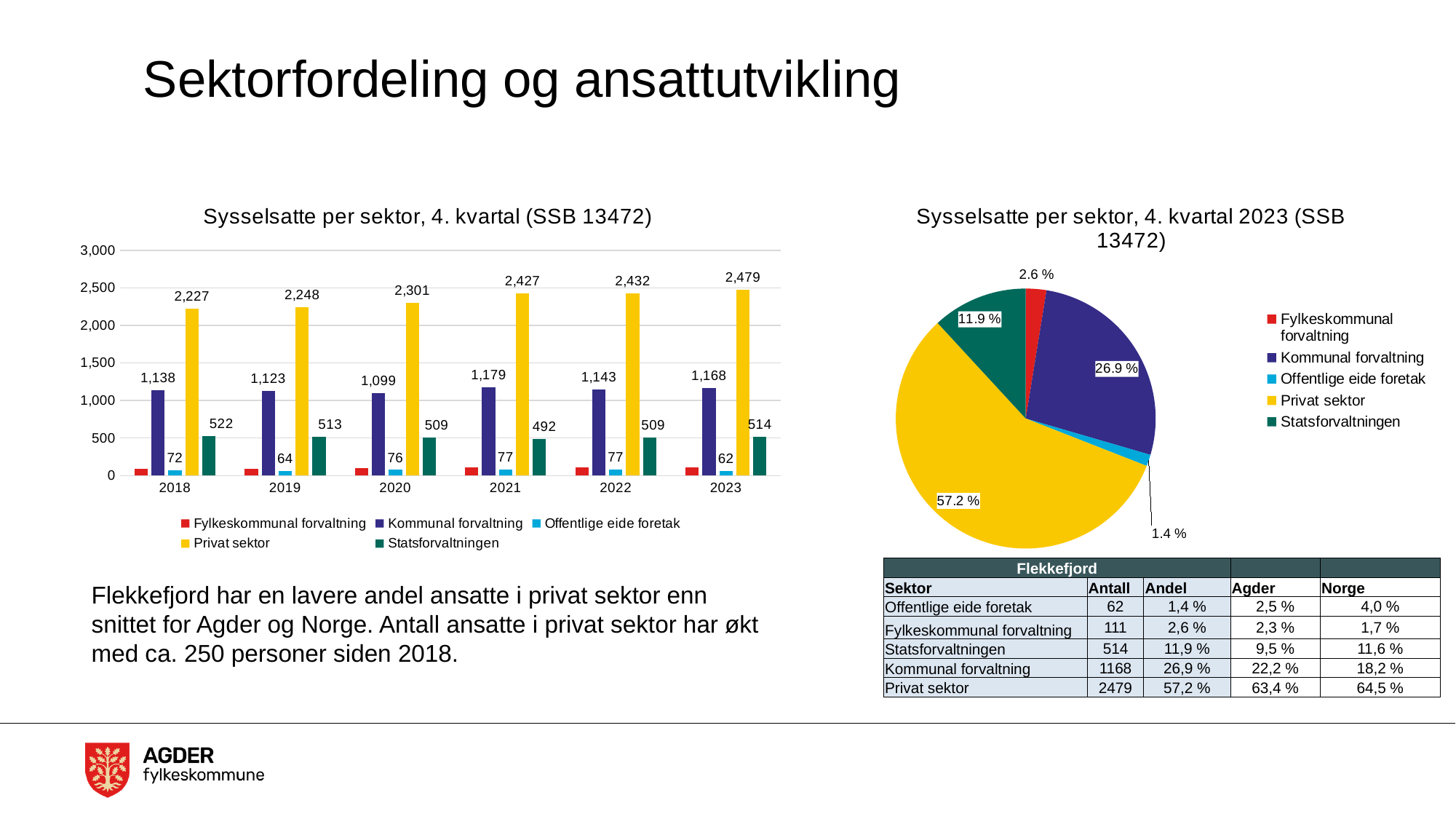
In the bar chart 'Sysselsatte per sektor, 4. kvartal (SSB 13472)', is the value for Fylkeskommunal forvaltning in 2023 greater or less than 500? less In the bar chart 'Sysselsatte per sektor, 4. kvartal (SSB 13472)', what is the value for Statsforvaltningen in 2021? 492 In the bar chart 'Sysselsatte per sektor, 4. kvartal (SSB 13472)', what is the value for Privat sektor in 2023? 2,479 In the bar chart 'Sysselsatte per sektor, 4. kvartal (SSB 13472)', how many years are shown on the x axis? 6 In the bar chart 'Sysselsatte per sektor, 4. kvartal (SSB 13472)', in which year is Offentlige eide foretak lowest? 2023 In the bar chart 'Sysselsatte per sektor, 4. kvartal (SSB 13472)', what is the value for Kommunal forvaltning in 2020? 1,099 In the bar chart 'Sysselsatte per sektor, 4. kvartal (SSB 13472)', what is the difference between Privat sektor in 2023 and in 2018? 252 In the bar chart 'Sysselsatte per sektor, 4. kvartal (SSB 13472)', is Kommunal forvaltning larger in 2021 or in 2022? 2021 In the pie chart 'Sysselsatte per sektor, 4. kvartal 2023 (SSB 13472)', what share does Statsforvaltningen have? 11.9 % In the bar chart 'Sysselsatte per sektor, 4. kvartal (SSB 13472)', how many series does the legend list? 5 What kind of chart is 'Sysselsatte per sektor, 4. kvartal 2023 (SSB 13472)' on the right of the slide? Pie chart In the bar chart 'Sysselsatte per sektor, 4. kvartal (SSB 13472)', in which year is Privat sektor highest? 2023